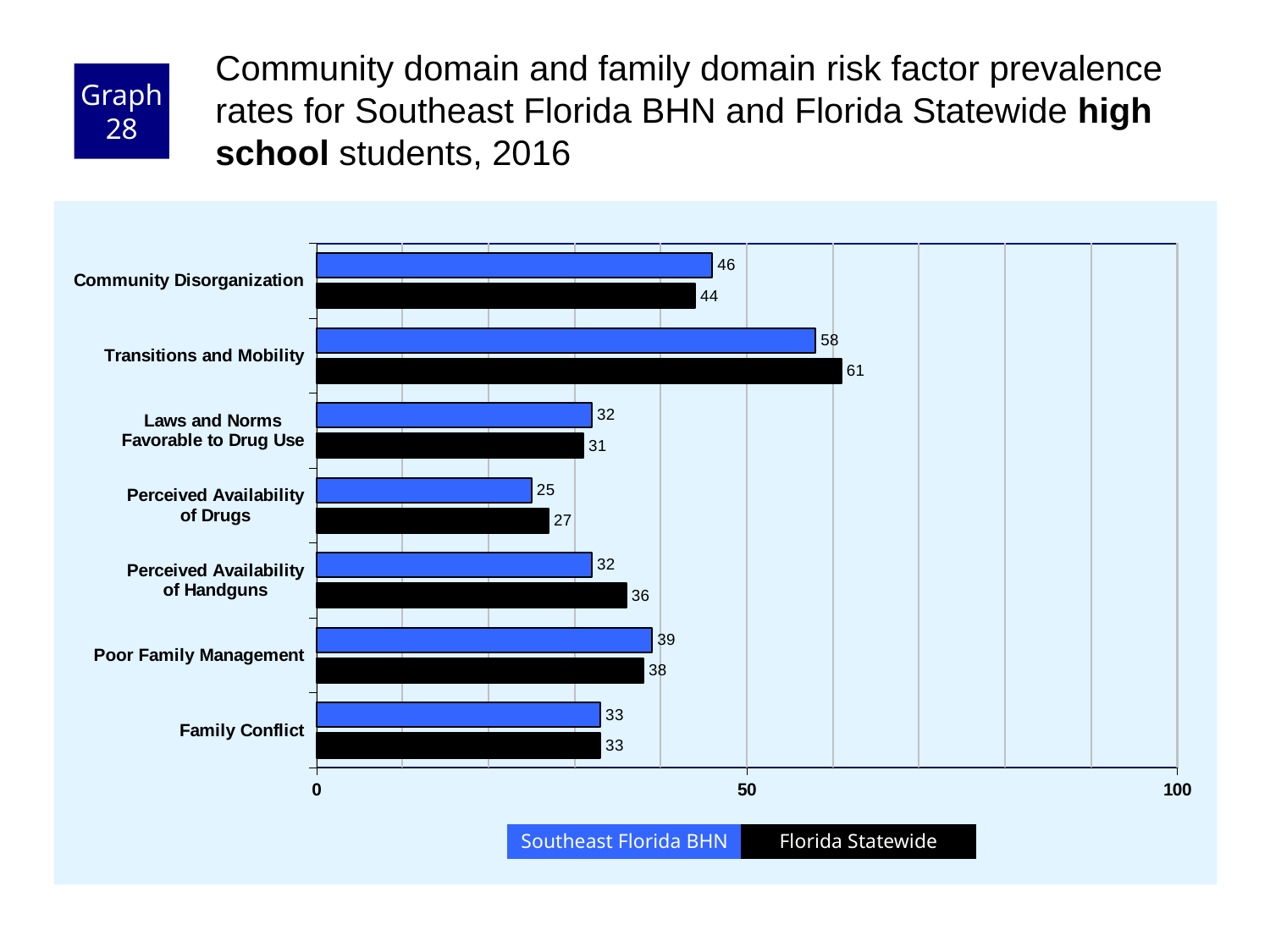
What is the Southeast Florida BHN value for Community Disorganization? 46 Is the Southeast Florida BHN value for Poor Family Management greater or less than 50? less How many series does the legend list? 2 Which risk factor has the lowest Southeast Florida BHN value? Perceived Availability of Drugs For Transitions and Mobility, which is larger: the Southeast Florida BHN value or the Florida Statewide value? Florida Statewide Which risk factor has the highest Florida Statewide value? Transitions and Mobility What is the Southeast Florida BHN value for Perceived Availability of Drugs? 25 How many risk factor categories are shown on the chart? 7 Which colour represents Florida Statewide in the chart? black What kind of chart is shown on the slide? bar chart What is the difference between the Florida Statewide and Southeast Florida BHN values for Perceived Availability of Handguns? 4 What is the Florida Statewide value for Transitions and Mobility? 61